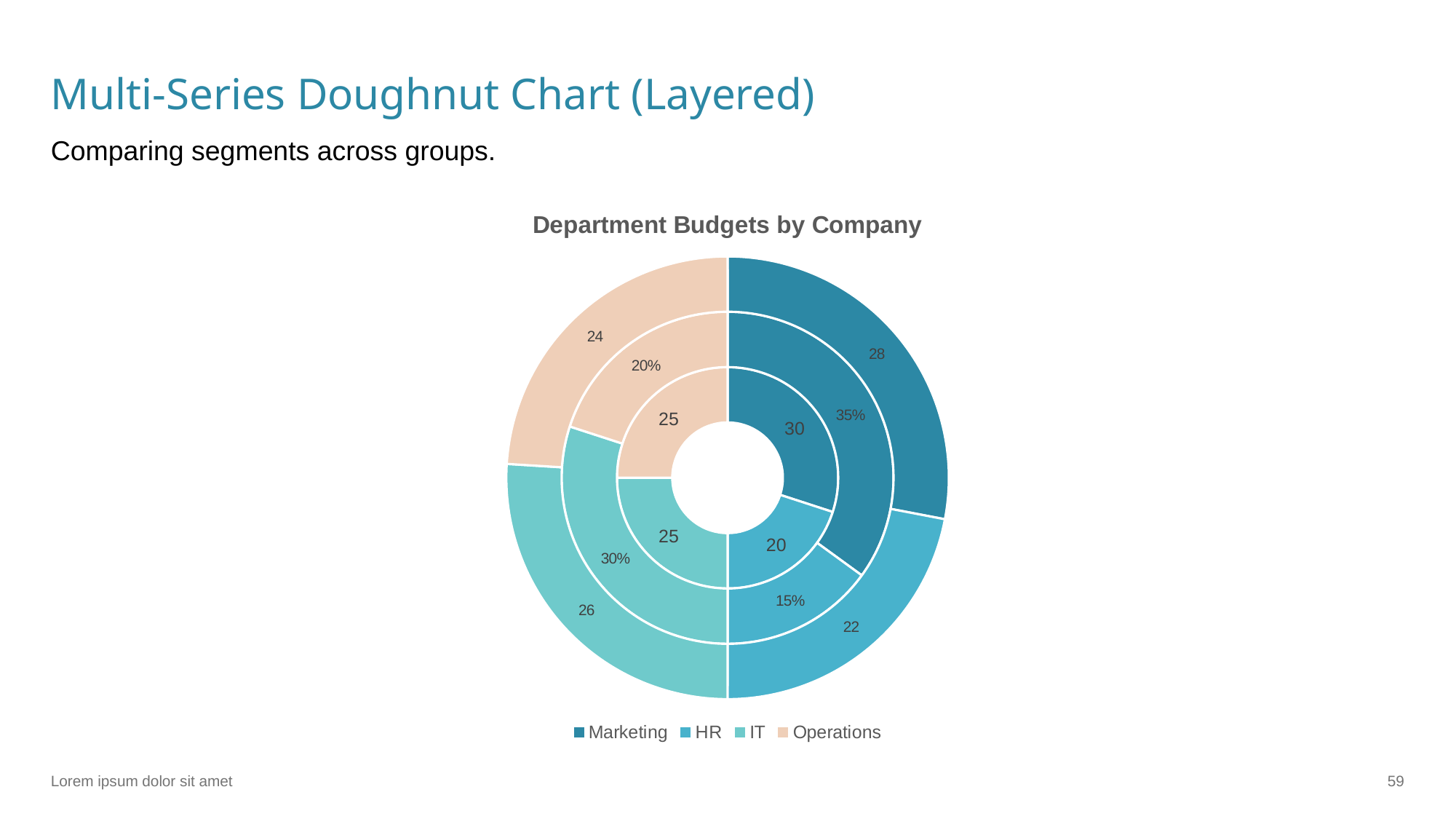
In the outermost ring, what is the value for Marketing? 28 In the middle ring, what is the value for Marketing? 35% How many categories does the legend list? 4 In the middle ring, which category has the lowest value? HR What kind of chart is shown on the slide? Doughnut chart In the outermost ring, what is the difference between the Marketing value and the HR value? 6 In the innermost ring, what is the value for Marketing? 30 In the innermost ring, which is larger: the value for IT or the value for HR? IT What is the title of the chart? Department Budgets by Company In the outermost ring, which category has the highest value? Marketing In the middle ring, what is the value for IT? 30% In the outermost ring, what is the value for HR? 22